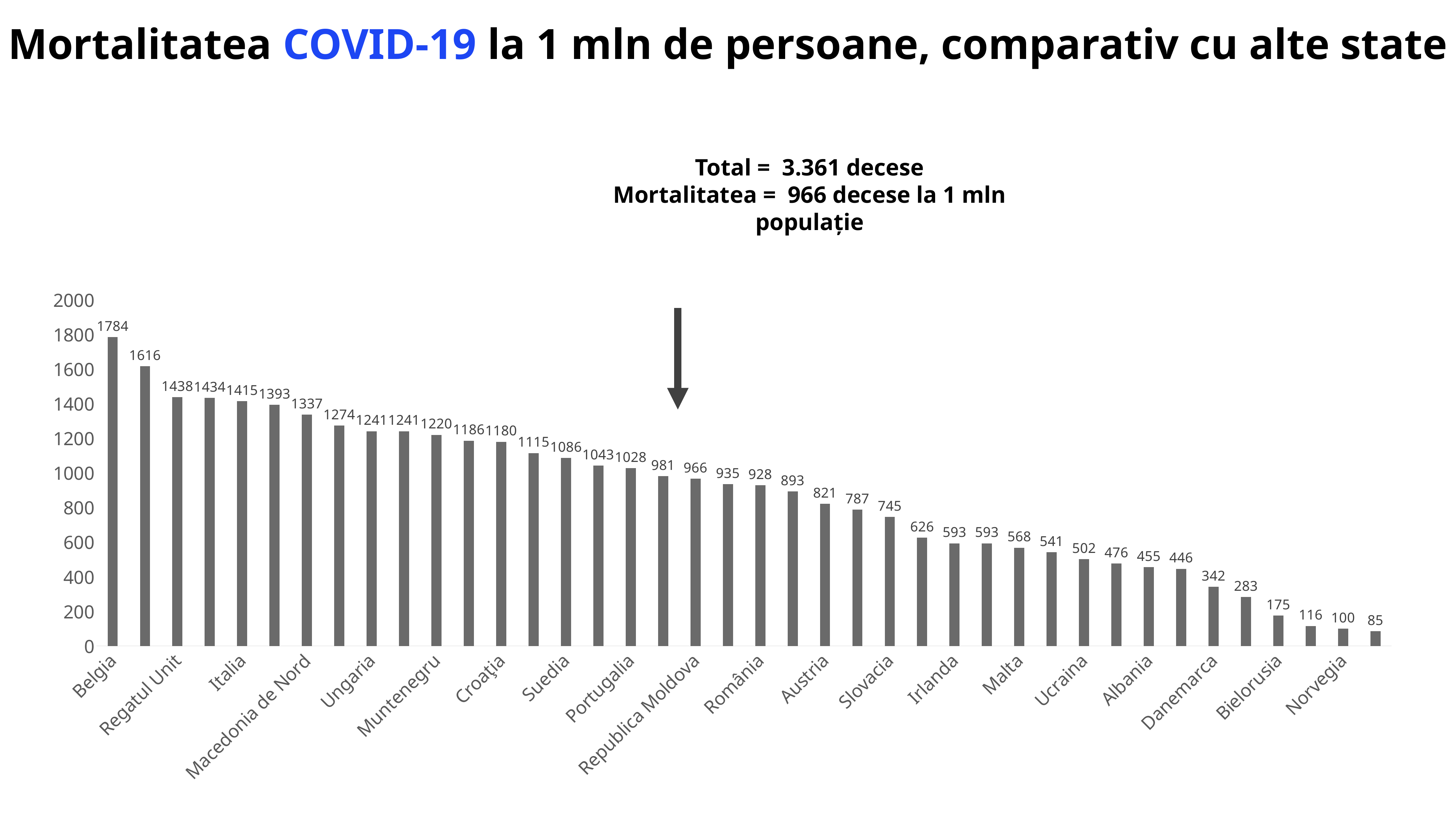
Is the value for Norvegia greater or less than 200? less Which country has the highest value? Belgia Do the values rise or fall from left to right along the x axis? fall What is the value for Ungaria? 1241 Which is larger, the value for Suedia or the value for Portugalia? Suedia What is the value for Italia? 1415 What is the lowest value shown on the chart? 85 What is the difference between the values for Belgia and Republica Moldova? 818 What is the value for Belgia? 1784 What is the value for Republica Moldova? 966 How many bars are plotted on the chart? 40 What kind of chart is shown? bar chart